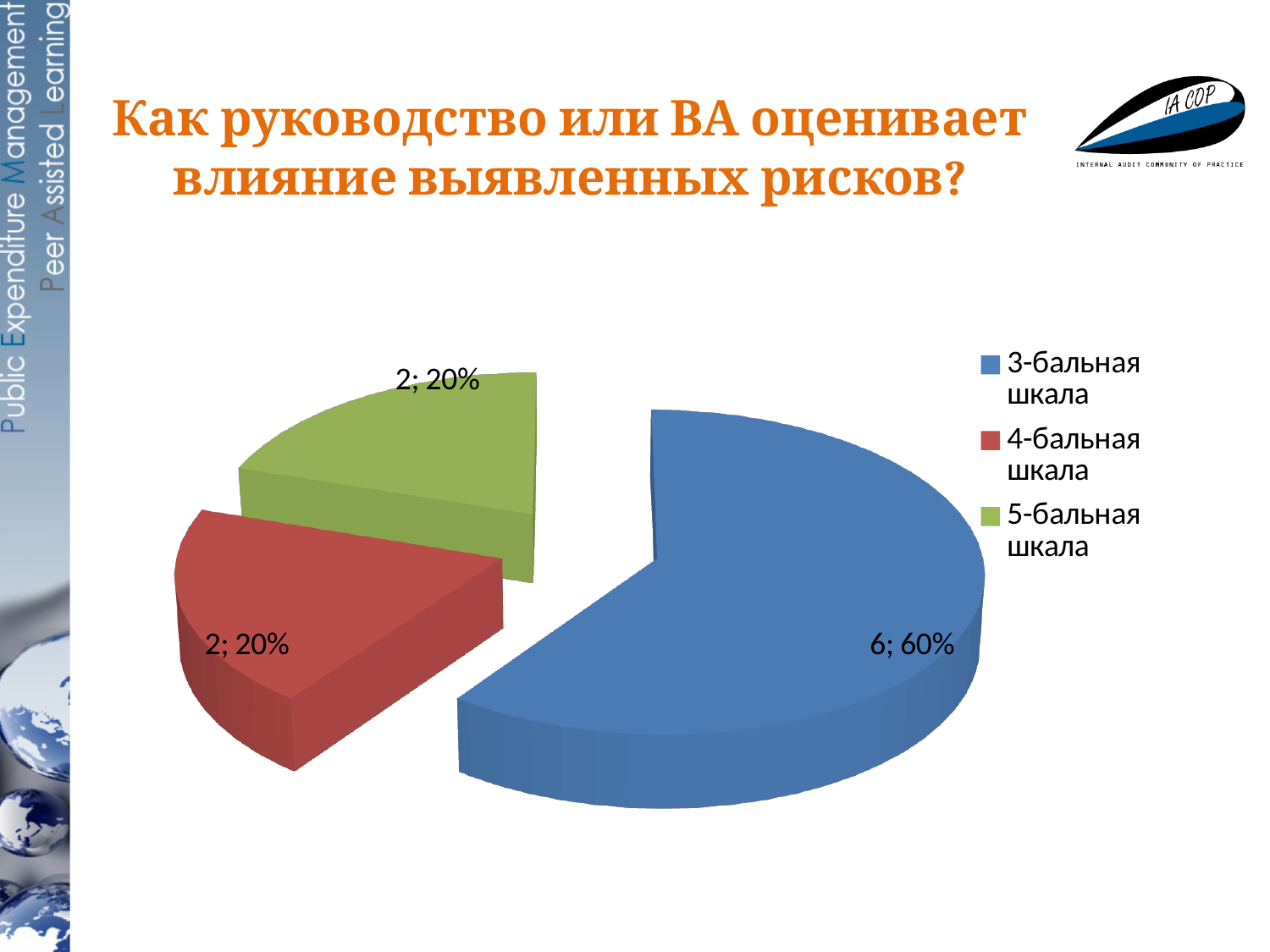
What kind of chart is shown on the slide? pie chart What share of the pie does the 4-бальная шкала slice represent? 20% Which is larger, the 3-бальная шкала slice or the 5-бальная шкала slice? 3-бальная шкала What is the count value shown for the 5-бальная шкала slice? 2 What is the count value shown for the 3-бальная шкала slice? 6 What is the difference in percentage points between the 3-бальная шкала slice and the 4-бальная шкала slice? 40 Which category has the largest slice of the pie? 3-бальная шкала How many slices does the pie chart have? 3 What share of the pie does the 3-бальная шкала slice represent? 60% What share of the pie does the 5-бальная шкала slice represent? 20% What colour is the 4-бальная шкала slice? red How many entries does the legend list? 3